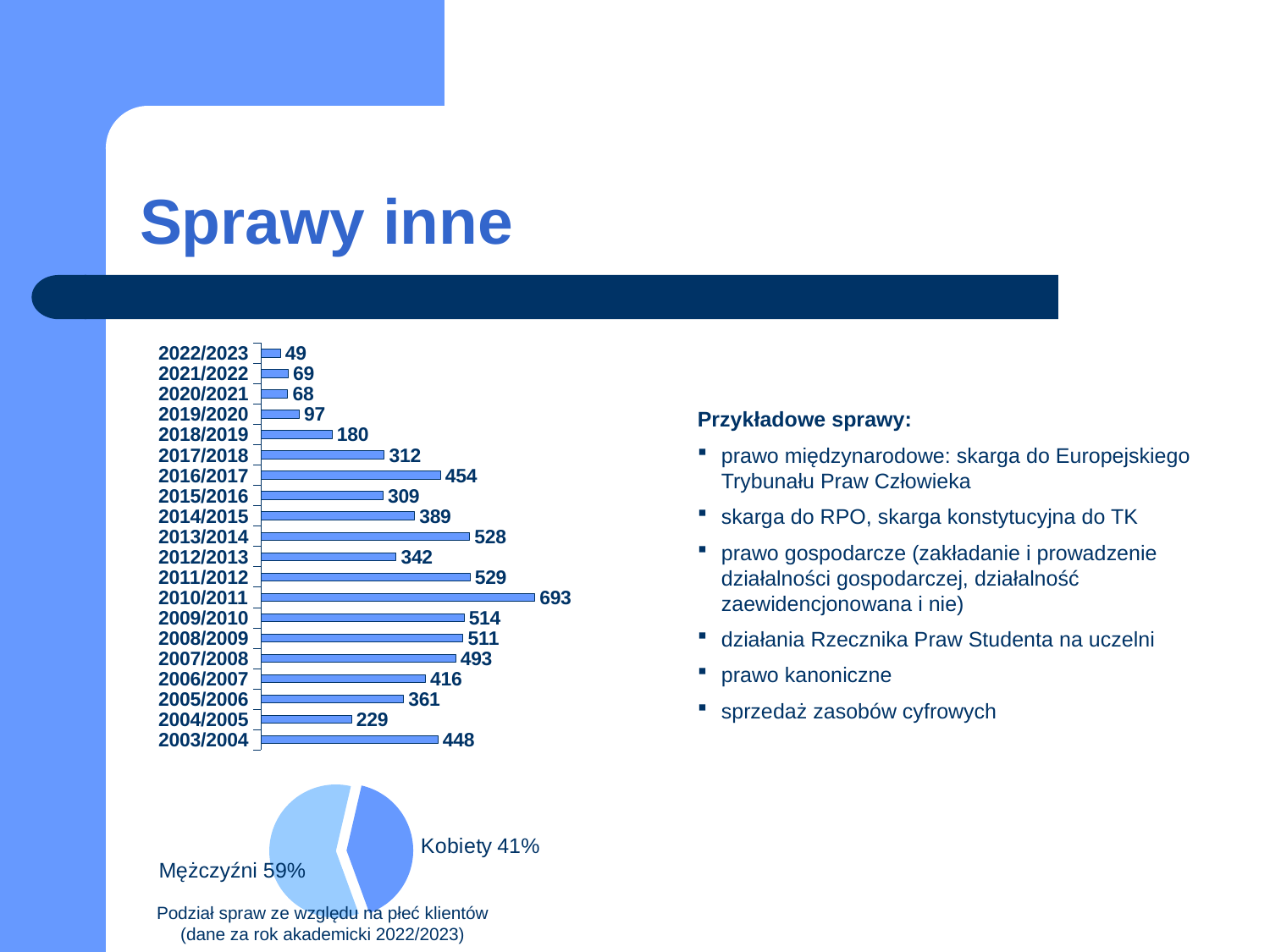
In the bar chart, which academic year has the lowest value? 2022/2023 In the bar chart, what is the value for 2022/2023? 49 How many academic years are shown in the bar chart? 20 In the pie chart, what share is labelled Kobiety? 41% What type of chart is the upper chart on the slide? bar chart In the pie chart, what share is labelled Mężczyźni? 59% In the bar chart, what is the difference between the values for 2003/2004 and 2004/2005? 219 What type of chart is the lower chart on the slide? pie chart In the bar chart, what is the value for 2010/2011? 693 In the bar chart, which academic year has the highest value? 2010/2011 In the bar chart, what is the value for 2016/2017? 454 In the bar chart, which is larger: the value for 2013/2014 or the value for 2012/2013? 2013/2014